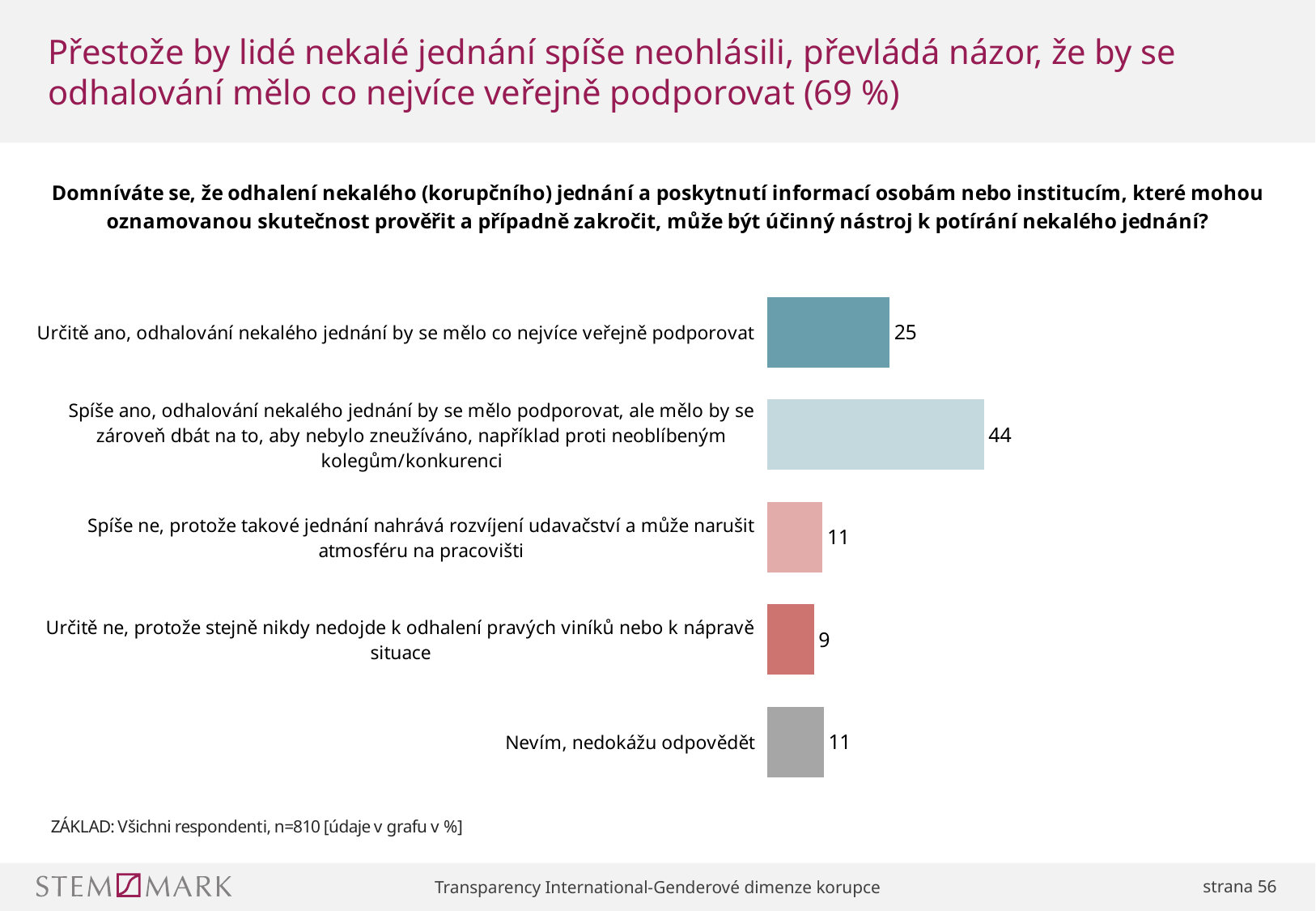
Which category has the lowest value? Určitě ne, protože stejně nikdy nedojde k odhalení pravých viníků nebo k nápravě situace Which category has the highest value? Spíše ano, odhalování nekalého jednání by se mělo podporovat, ale mělo by se zároveň dbát na to, aby nebylo zneužíváno, například proti neoblíbeným kolegům/konkurenci What is the difference between the values for "Spíše ne" and "Určitě ne"? 2 What value is shown for "Určitě ne, protože stejně nikdy nedojde k odhalení pravých viníků nebo k nápravě situace"? 9 What value is shown for "Nevím, nedokážu odpovědět"? 11 What value is shown for "Určitě ano, odhalování nekalého jednání by se mělo co nejvíce veřejně podporovat"? 25 What value is shown for "Spíše ano, odhalování nekalého jednání by se mělo podporovat, ale mělo by se zároveň dbát na to, aby nebylo zneužíváno..."? 44 According to the note below the chart, how many respondents form the base (n)? 810 What is the difference between the values for "Spíše ano" and "Určitě ano"? 19 What kind of chart is shown on the slide? Bar chart Which is larger, the value for "Určitě ano" or the value for "Spíše ne"? Určitě ano How many categories does the chart show? 5